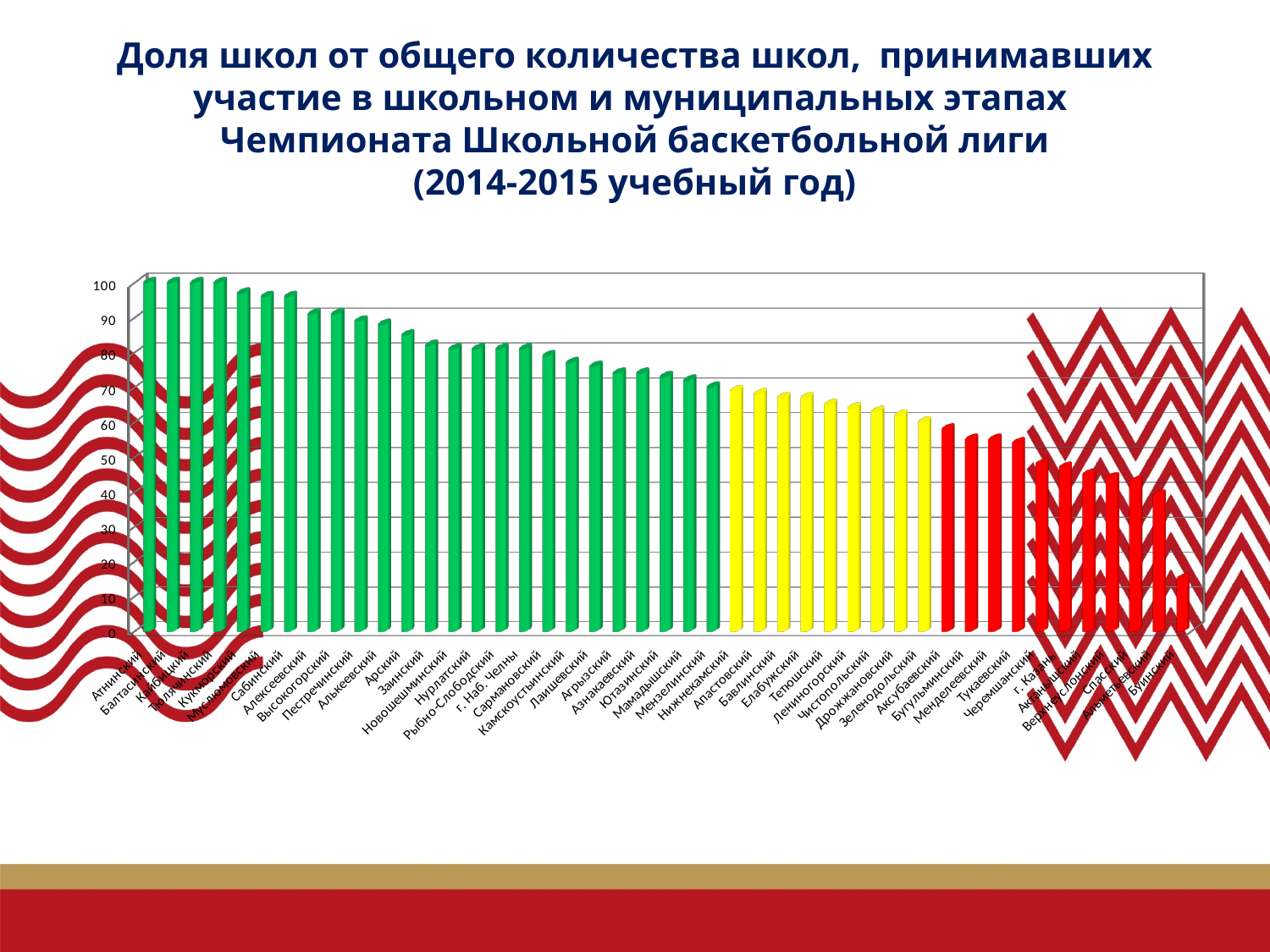
Is the value for Буинский greater or less than 20? less Which has the larger value, Черемшанский or Сабинский? Сабинский Do the values generally rise or fall from left to right along the x axis? fall How many different bar colours are used in the chart? 3 Is the value for Сабинский greater or less than 90? greater Which category has the lowest value on the chart? Буинский Is the value for Елабужский greater or less than 60? greater Which has the larger value, Арский or Буинский? Арский What kind of chart is shown on the slide? bar chart